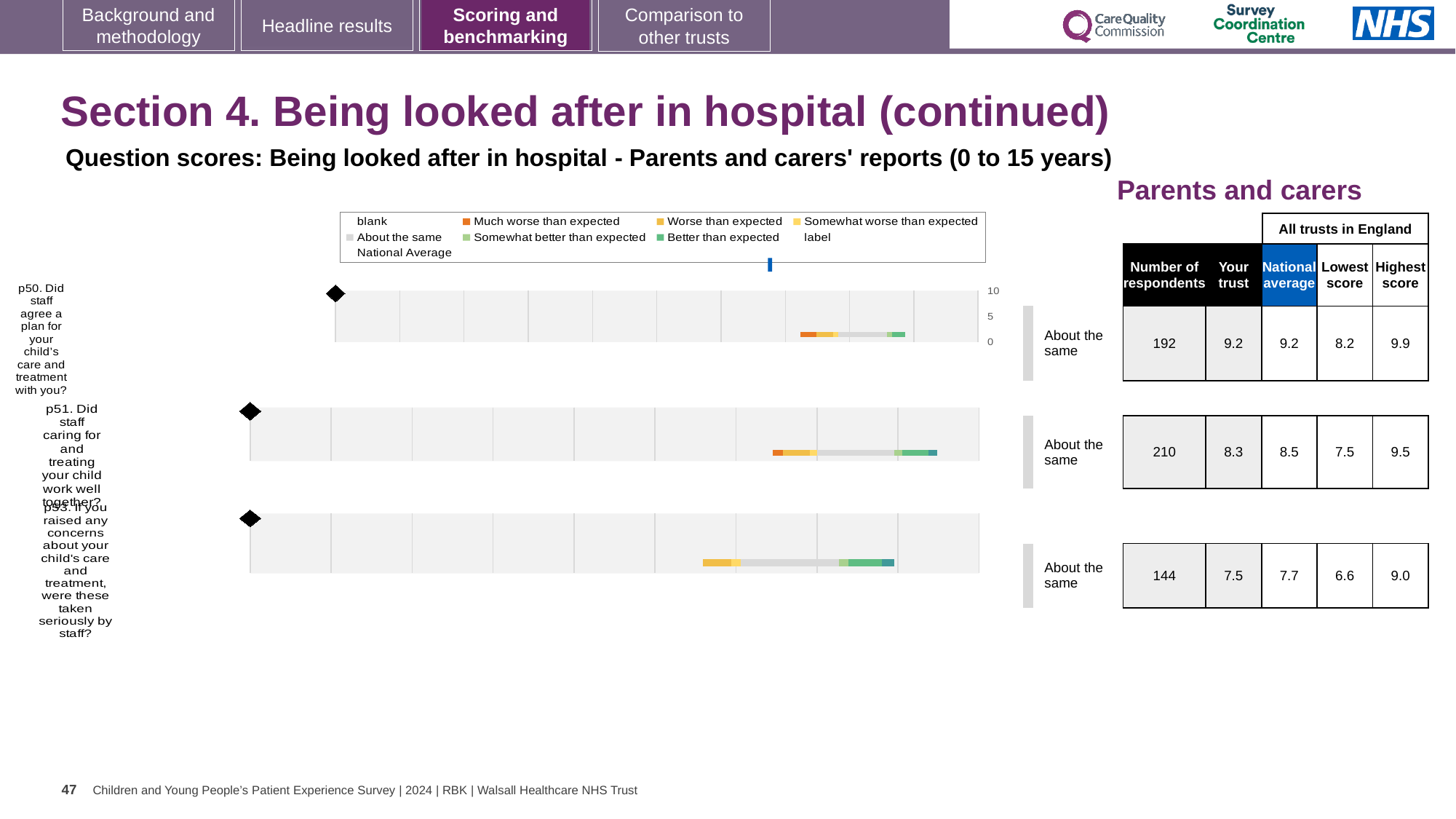
In the table next to the charts, what is the 'Your trust' score for p51? 8.3 In the table next to the charts, what is the highest score for p50? 9.9 In the chart legend, what colour represents 'Much worse than expected'? orange In the table next to the charts, what is the number of respondents for p50? 192 Which question has the highest number of respondents in the table? p51 What kind of chart is used to show the expected range for question p50? bar chart In the chart legend, what colour represents 'About the same'? grey In the table next to the charts, what is the national average for p53? 7.7 For p50, what is the difference between the highest score and the lowest score in the table? 1.7 How many question charts are shown on the slide? 3 For p51, which is larger: the 'Your trust' score or the national average? National average Which question has the lowest 'Your trust' score in the table? p53